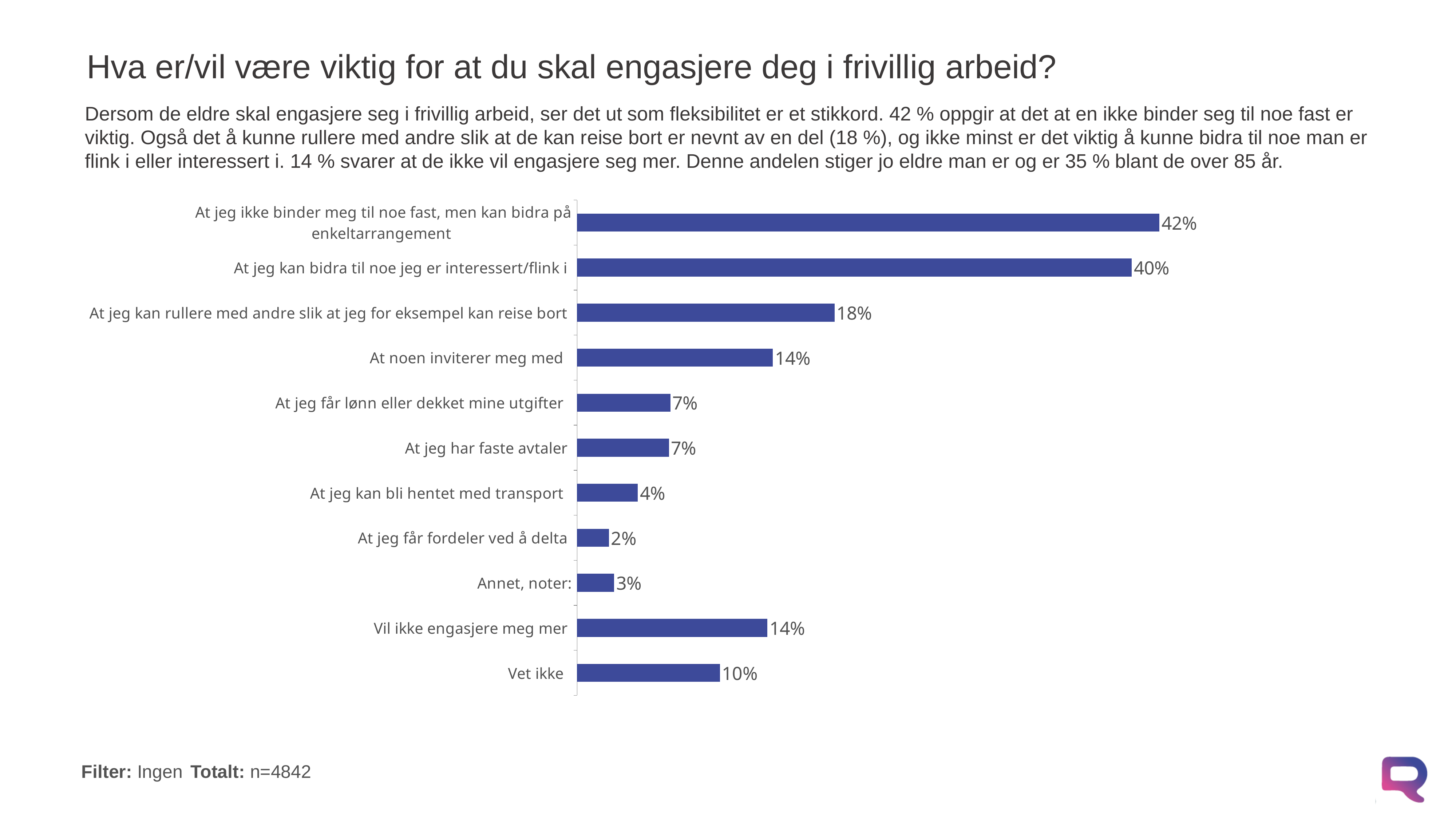
What is the value for "At jeg kan rullere med andre slik at jeg for eksempel kan reise bort"? 18% What is the difference between the values for "At jeg ikke binder meg til noe fast, men kan bidra på enkeltarrangement" and "At jeg kan bidra til noe jeg er interessert/flink i"? 2% What is the total sample size (n) stated at the bottom of the slide? n=4842 Which category has the highest value? At jeg ikke binder meg til noe fast, men kan bidra på enkeltarrangement How many categories are shown in the chart? 11 What is the value for "Vet ikke"? 10% What is the value for "At jeg kan bli hentet med transport"? 4% Which category has the lowest value? At jeg får fordeler ved å delta What is the difference between the values for "At noen inviterer meg med" and "At jeg får lønn eller dekket mine utgifter"? 7% Which is larger, the value for "Vet ikke" or the value for "Annet, noter:"? Vet ikke What kind of chart is shown on the slide? Bar chart What is the value for "Vil ikke engasjere meg mer"? 14%